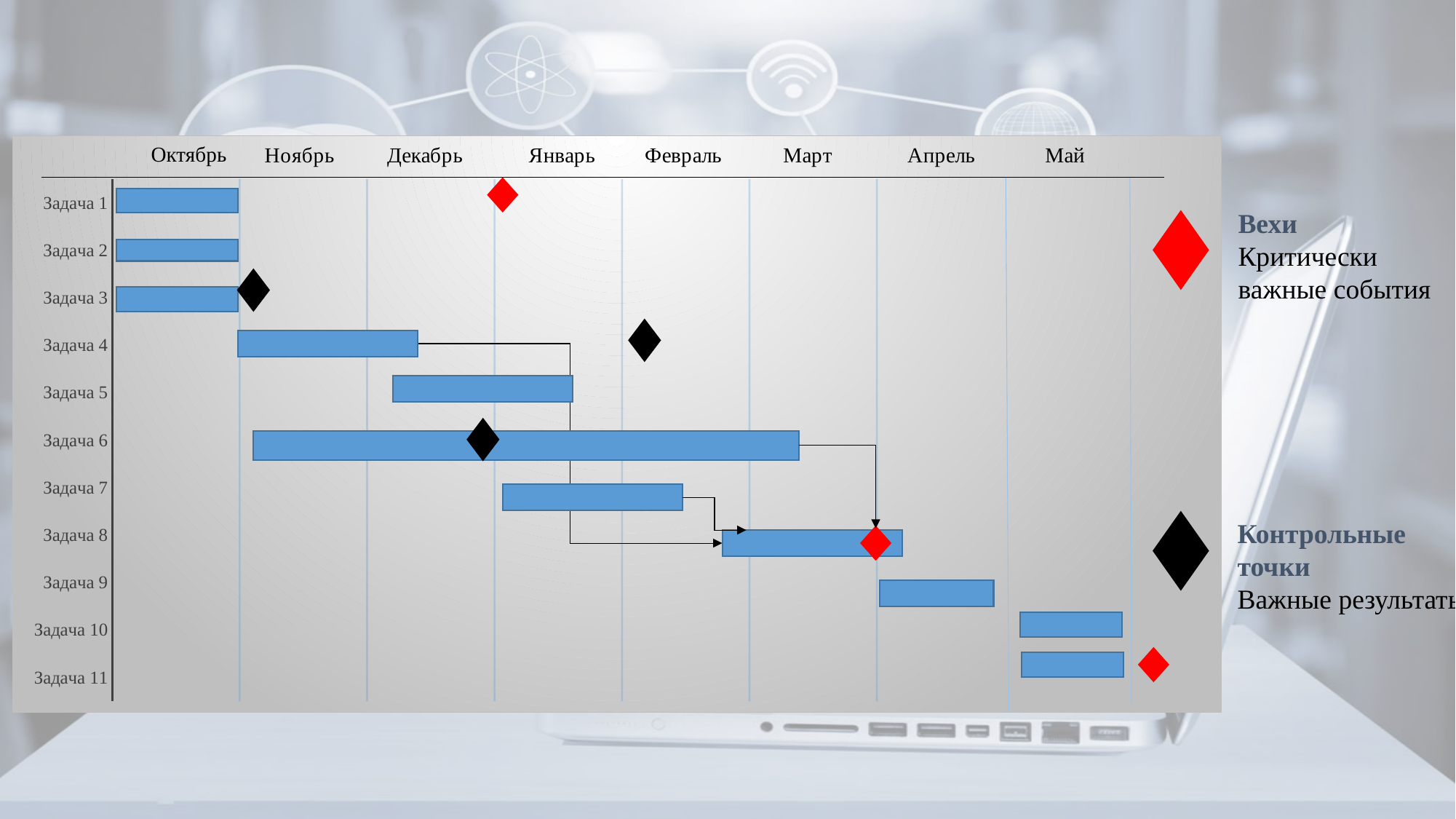
What is the first month shown on the chart's time axis? Октябрь How many months are shown along the top axis of the chart? 8 Which is longer, the bar for Задача 6 or the bar for Задача 5? Задача 6 What kind of chart is shown on the slide? Gantt chart Which task has the longest bar on the chart? Задача 6 In which month does the bar for Задача 7 start? Январь According to the legend, what does the black diamond represent? Контрольные точки (Важные результаты) According to the legend, what does the red diamond represent? Вехи (Критически важные события) In which month does the bar for Задача 1 start? Октябрь How many tasks (Задача) are listed on the chart? 11 Which tasks have bars in Май? Задача 10 and Задача 11 How many red diamonds are placed on the chart? 3